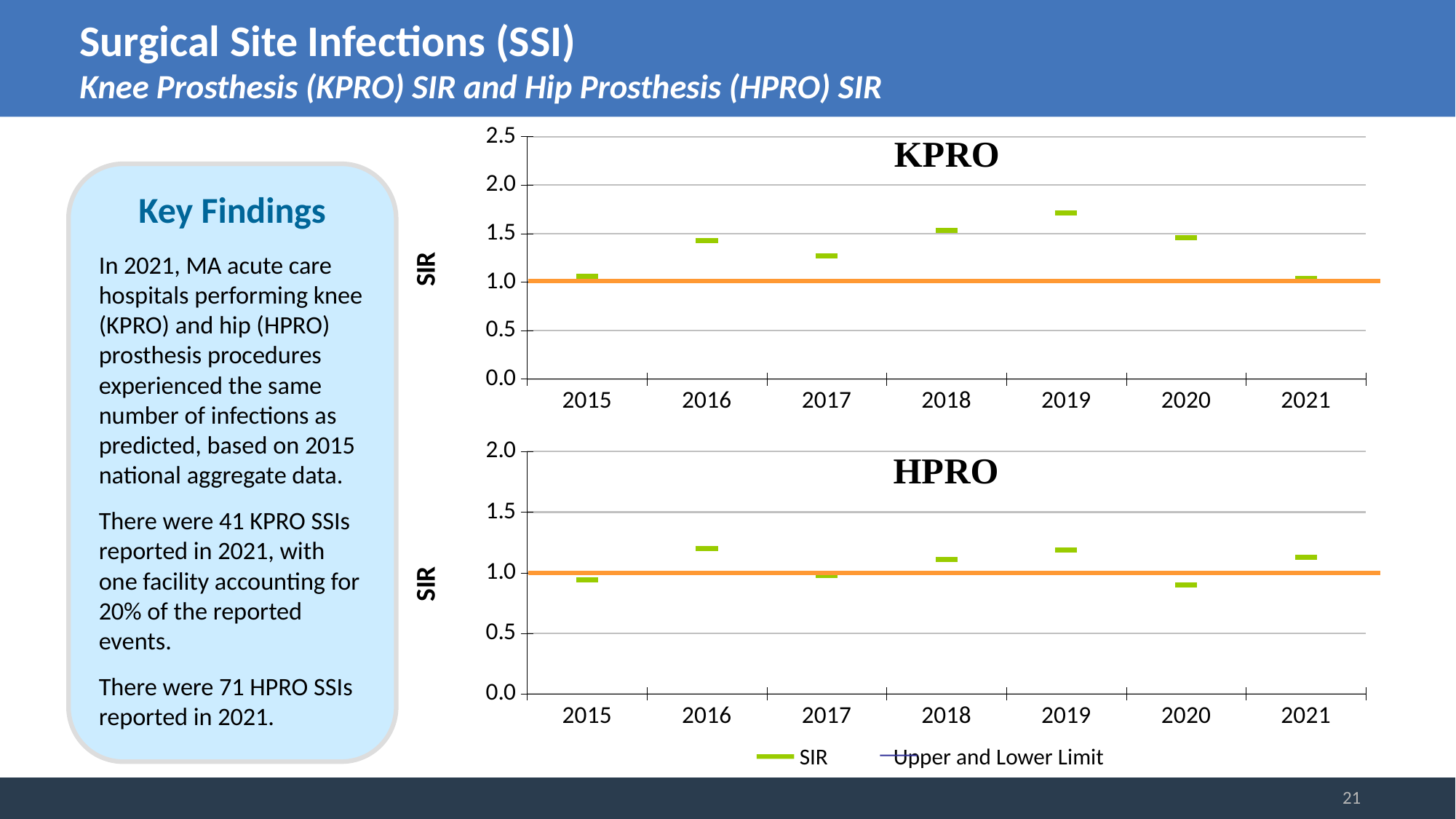
How many years are plotted on the x axis of the KPRO chart? 7 In the HPRO chart, which year has the lowest SIR? 2020 In the HPRO chart, which is larger, the SIR for 2016 or the SIR for 2020? 2016 In the KPRO chart, is the SIR value for 2019 greater or less than 1.5? greater In the KPRO chart, is the SIR value for 2017 greater or less than 1.0? greater In the KPRO chart, is the SIR value for 2016 greater or less than 1.5? less What is the label on the y axis of the HPRO chart? SIR In the KPRO chart, which year has the highest SIR? 2019 In the KPRO chart, which is larger, the SIR for 2019 or the SIR for 2015? 2019 How many series does the legend below the HPRO chart list? 2